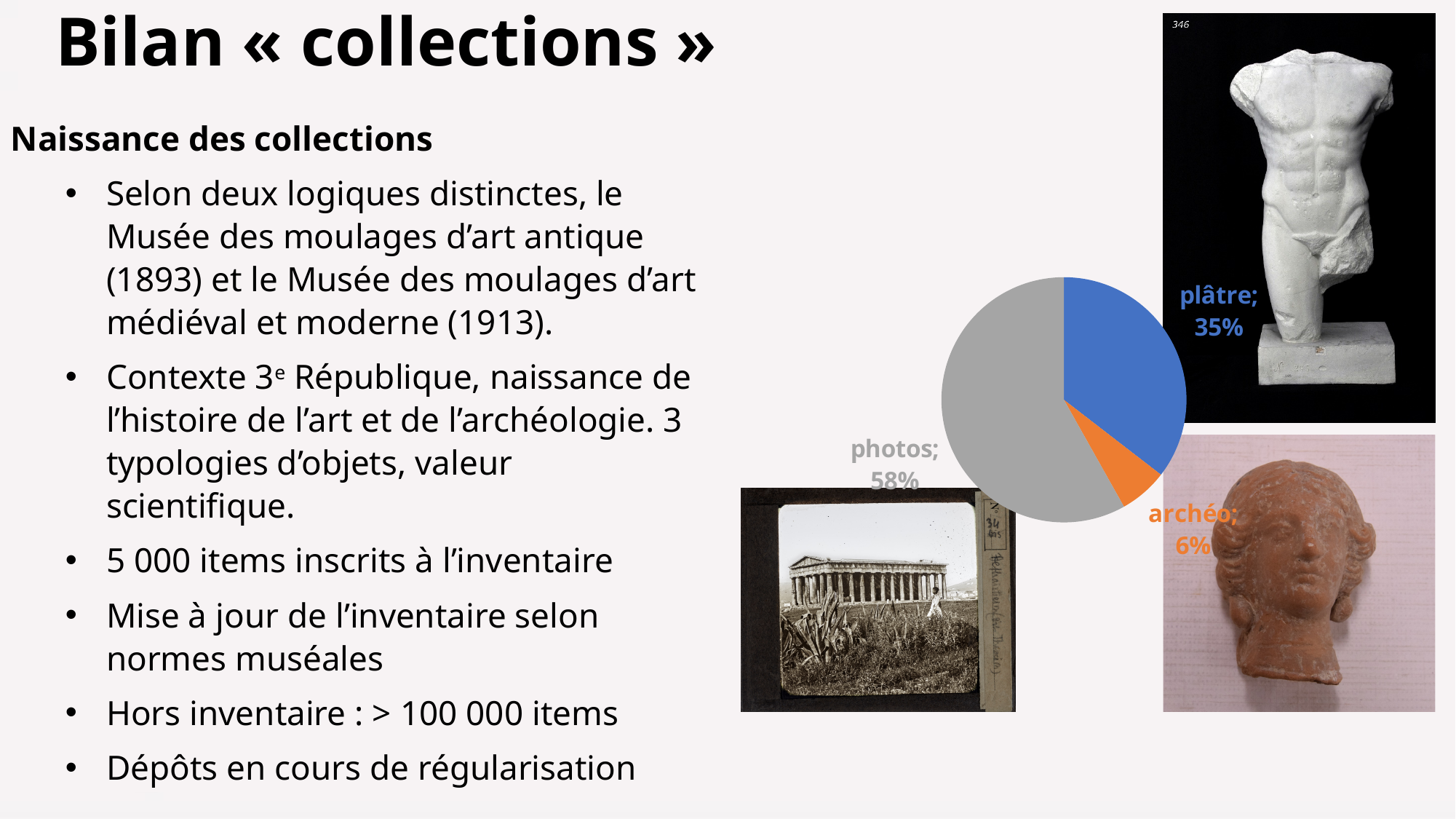
What is the difference in percentage points between the 'plâtre' slice and the 'archéo' slice? 29 What kind of chart is shown on the slide? pie chart What colour is the 'archéo' slice of the pie chart? orange Which category has the smallest slice in the pie chart? archéo What is the difference in percentage points between the 'photos' slice and the 'plâtre' slice? 23 What colour is the 'photos' slice of the pie chart? grey Which category has the largest slice in the pie chart? photos What share of the pie chart is labelled 'archéo'? 6% How many slices does the pie chart have? 3 What share of the pie chart is labelled 'photos'? 58% Which slice is larger, 'plâtre' or 'archéo'? plâtre What share of the pie chart is labelled 'plâtre'? 35%